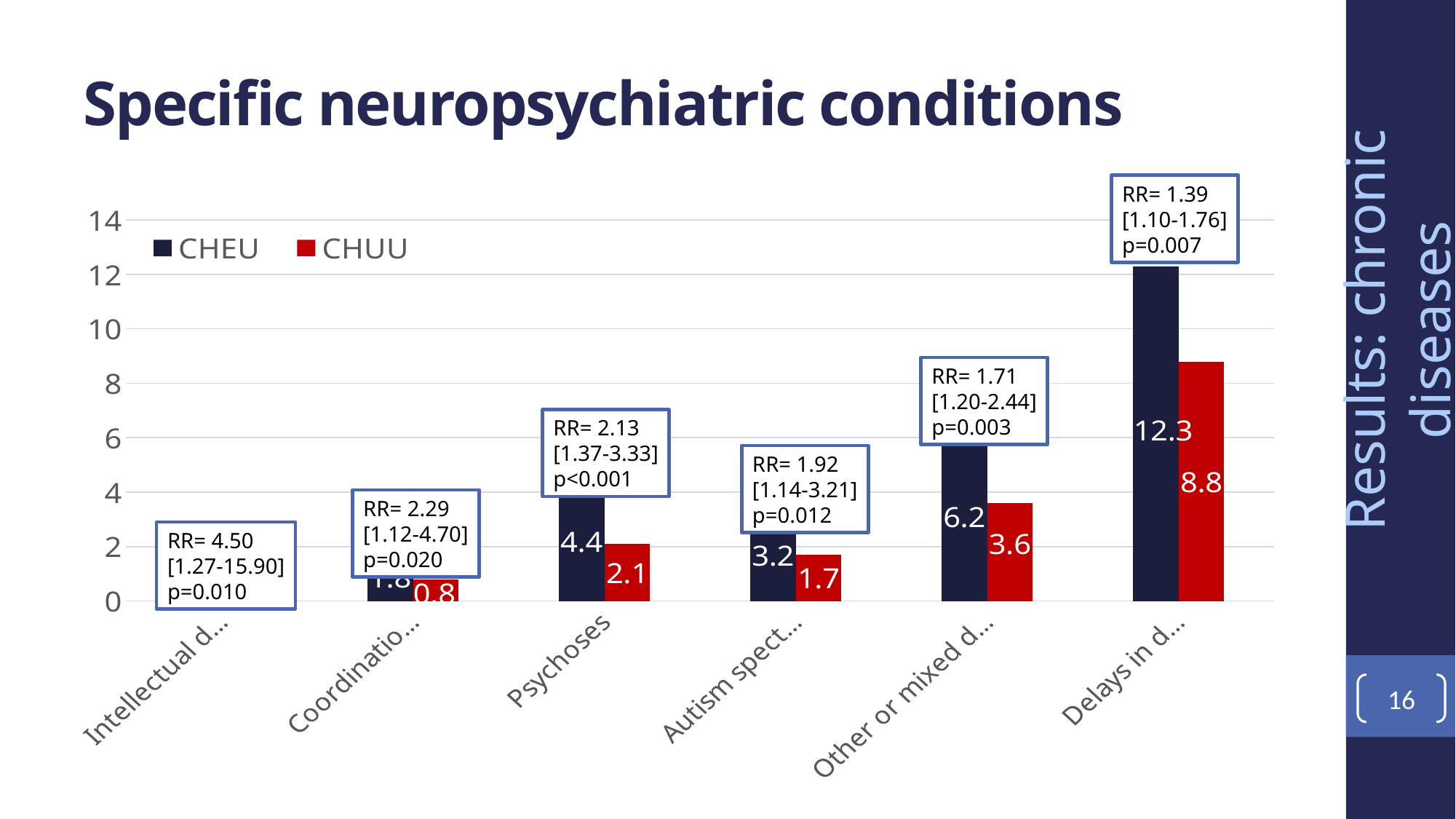
Which category has the highest CHEU value? the rightmost category (Delays in d...) What kind of chart is shown on the slide? bar chart What is the difference between the CHEU and CHUU values for the rightmost category (Delays in d...)? 3.5 What is the CHEU value for the rightmost category (Delays in d...)? 12.3 What is the CHUU value for the rightmost category (Delays in d...)? 8.8 What is the difference between the CHEU and CHUU values for Psychoses? 2.3 What is the CHEU value for Psychoses? 4.4 What are the two series named in the legend? CHEU and CHUU Is the CHEU value for the rightmost category (Delays in d...) greater or less than 10? greater How many series does the legend list? 2 What is the CHUU value for Psychoses? 2.1 How many categories are plotted along the x axis? 6